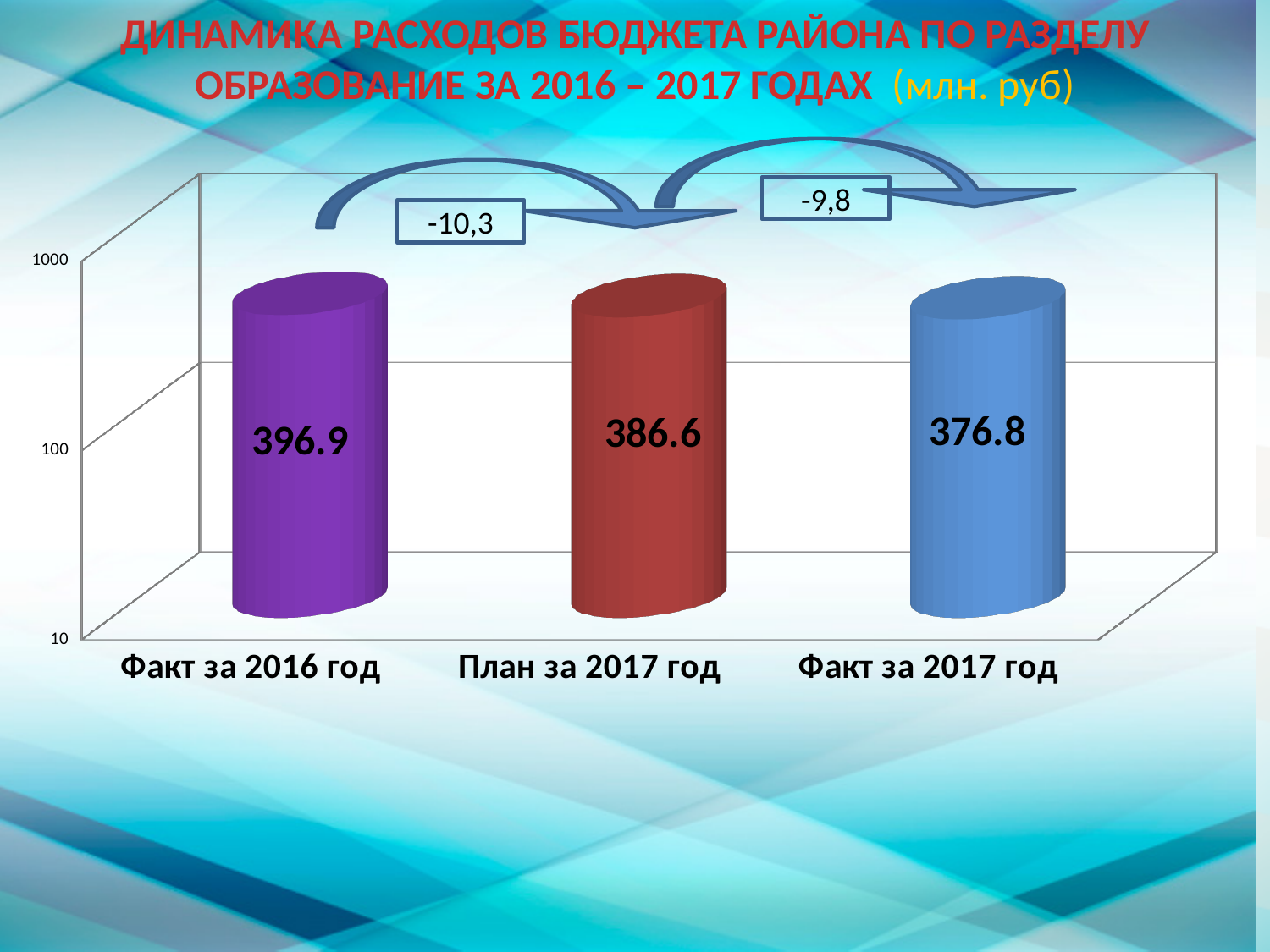
How many categories are shown on the chart? 3 What is the value for План за 2017 год? 386.6 Is the value for План за 2017 год greater or less than 100? greater Which category has the lowest value? Факт за 2017 год Which is larger, the value for Факт за 2016 год or the value for Факт за 2017 год? Факт за 2016 год What is the difference between the values for План за 2017 год and Факт за 2017 год? 9.8 What is the difference between the values for Факт за 2016 год and План за 2017 год? 10.3 What is the value for Факт за 2017 год? 376.8 Do the values rise or fall from left to right along the x axis? fall Which category has the highest value? Факт за 2016 год What kind of chart is shown on the slide? bar chart What is the value for Факт за 2016 год? 396.9